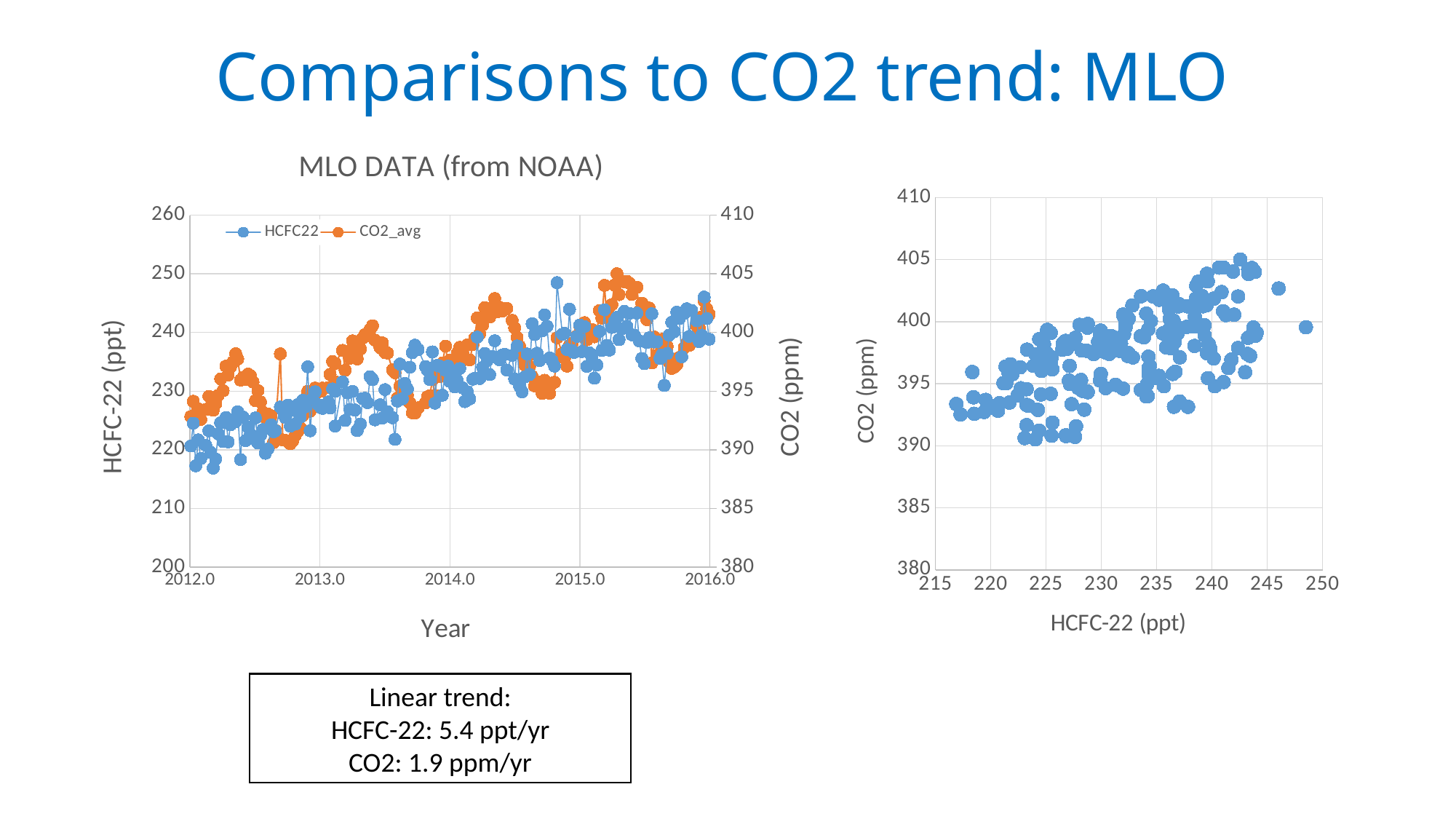
In the left chart, is the highest CO2_avg value in 2015 greater or less than 400? greater How many series does the legend of the left chart list? 2 What kind of chart is the chart on the right? scatter chart What is the title of the chart on the left? MLO DATA (from NOAA) What are the two series named in the legend of the left chart? HCFC22 and CO2_avg In the left chart, is the CO2_avg value at the start of 2012 greater or less than 395? less In the left chart, is the HCFC22 value at the start of 2012 greater or less than 230? less In the left chart, are the HCFC22 values in 2015 higher or lower than those in 2012? higher In the left chart, does the CO2_avg series generally rise or fall from 2012 to 2016? rise In the right chart, does CO2 tend to increase or decrease as HCFC-22 increases? increase In the left chart, does the HCFC22 series generally rise or fall from 2012 to 2016? rise